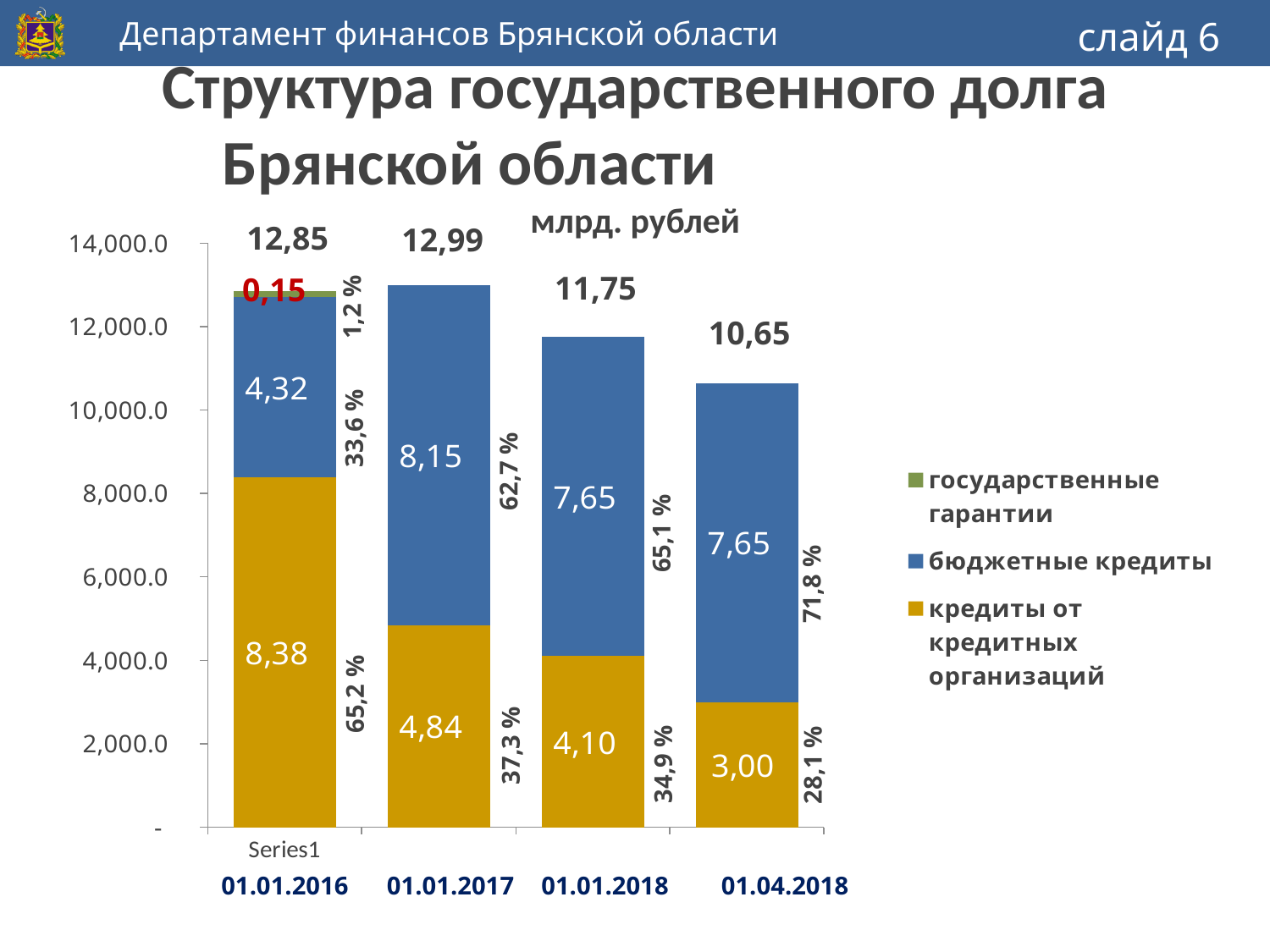
On which date is the total state debt the highest? 01.01.2017 How many series does the legend list? 3 What kind of chart is shown on the slide? stacked bar chart What is the value for бюджетные кредиты on 01.01.2017? 8,15 On which date is the value for кредиты от кредитных организаций the lowest? 01.04.2018 What is the value for кредиты от кредитных организаций on 01.04.2018? 3,00 What share of the total debt do бюджетные кредиты make up on 01.04.2018? 71,8 % What is the total of the stacked bar for 01.01.2018? 11,75 What is the difference between the кредиты от кредитных организаций values on 01.01.2016 and 01.01.2017? 3,54 What is the value for государственные гарантии on 01.01.2016? 0,15 Which is larger on 01.01.2016: бюджетные кредиты or кредиты от кредитных организаций? кредиты от кредитных организаций How many dates (bars) are shown on the chart? 4